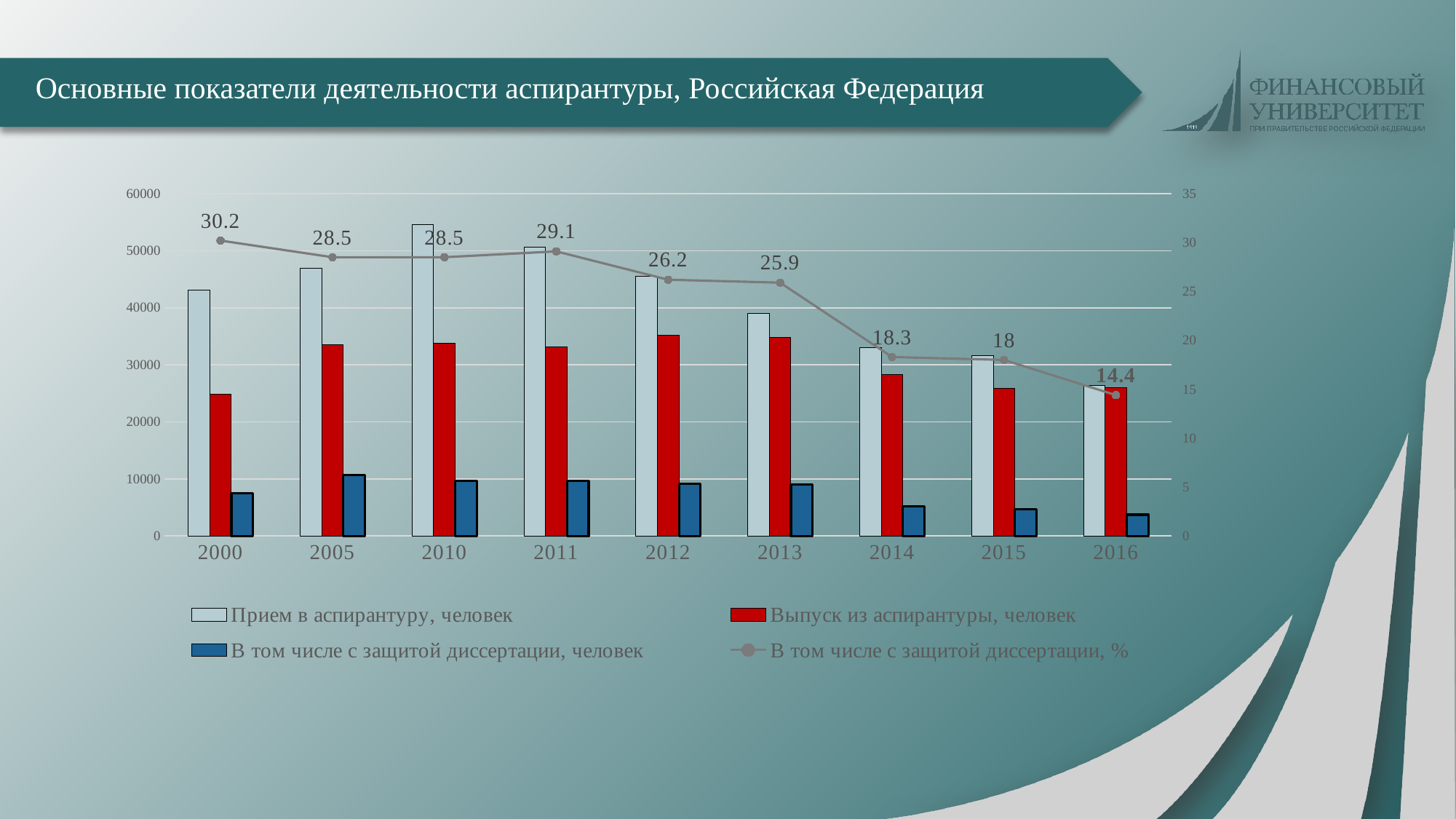
Does the series 'В том числе с защитой диссертации, %' generally rise or fall from 2000 to 2016? fall In which year is the series 'В том числе с защитой диссертации, %' lowest? 2016 Is the value of 'В том числе с защитой диссертации, человек' for 2014 greater or less than 10000? less What is the value of the series 'В том числе с защитой диссертации, %' for 2016? 14.4 Is the value of 'Прием в аспирантуру, человек' for 2010 greater or less than 50000? greater Which year has the larger 'В том числе с защитой диссертации, %' value, 2011 or 2012? 2011 What is the value of the series 'В том числе с защитой диссертации, %' for 2000? 30.2 In which year is the series 'В том числе с защитой диссертации, %' highest? 2000 How many years are shown on the x axis? 9 What is the difference between the 'В том числе с защитой диссертации, %' values for 2000 and 2016? 15.8 What is the value of the series 'В том числе с защитой диссертации, %' for 2013? 25.9 How many series does the legend list? 4